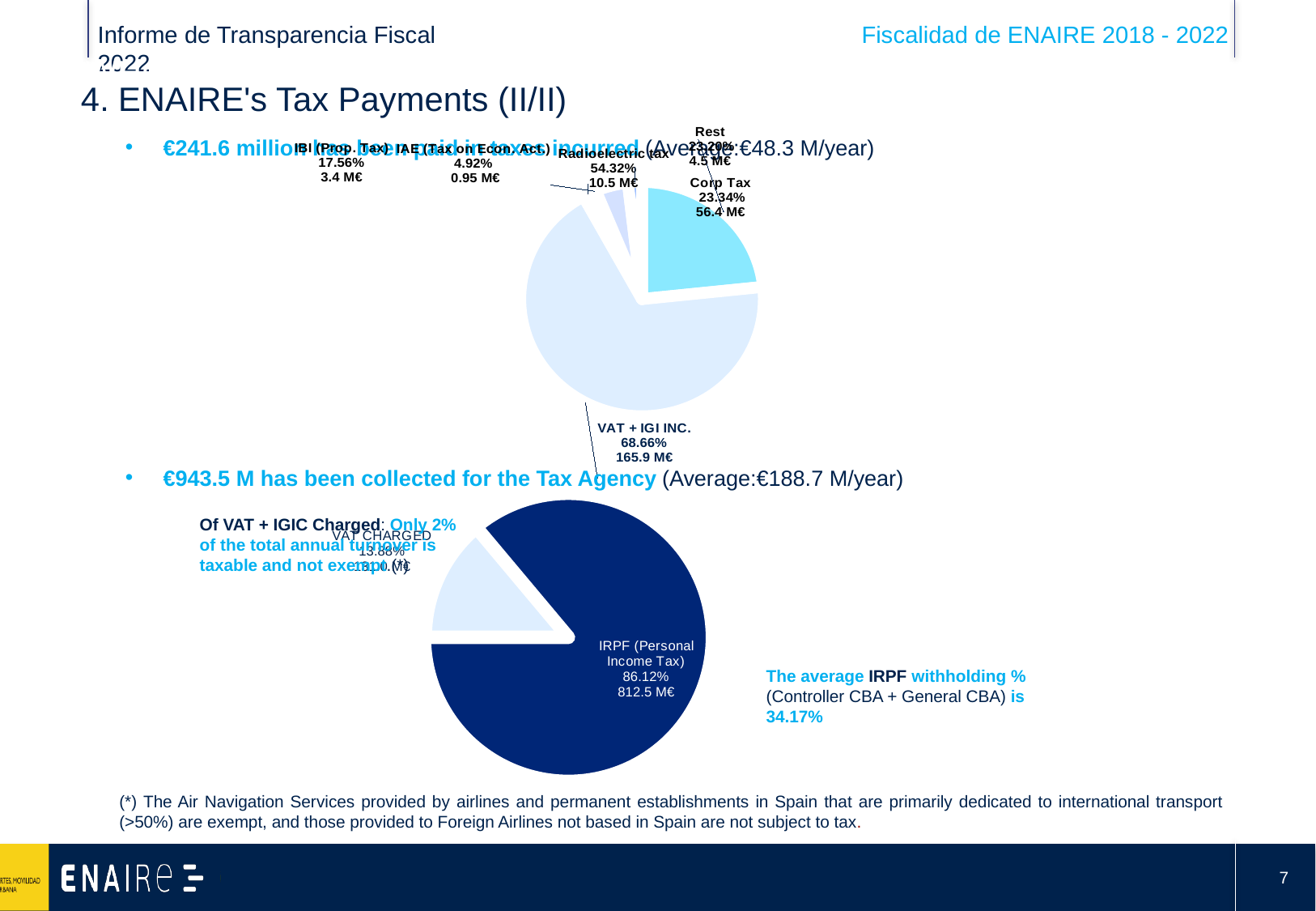
In the bottom pie chart, what percentage is shown for VAT CHARGED? 13.88% In the top pie chart, which category has the largest slice? VAT + IGI INC. What type of chart is the bottom chart on the slide? Pie chart In the top pie chart, what value is shown for VAT + IGI INC.? 165.9 M€ In the top pie chart, what is the difference in M€ between VAT + IGI INC. and Corp Tax? 109.5 M€ In the top pie chart, what percentage is shown for Corp Tax? 23.34% In the bottom pie chart, what percentage is shown for IRPF (Personal Income Tax)? 86.12% In the top pie chart, which is larger, Corp Tax or Radioelectric tax? Corp Tax In the bottom pie chart, what value in M€ is shown for IRPF (Personal Income Tax)? 812.5 M€ How many slices does the bottom pie chart have? 2 In the top pie chart, what value is shown for Radioelectric tax? 10.5 M€ In the top pie chart, what value in M€ is shown for Corp Tax? 56.4 M€